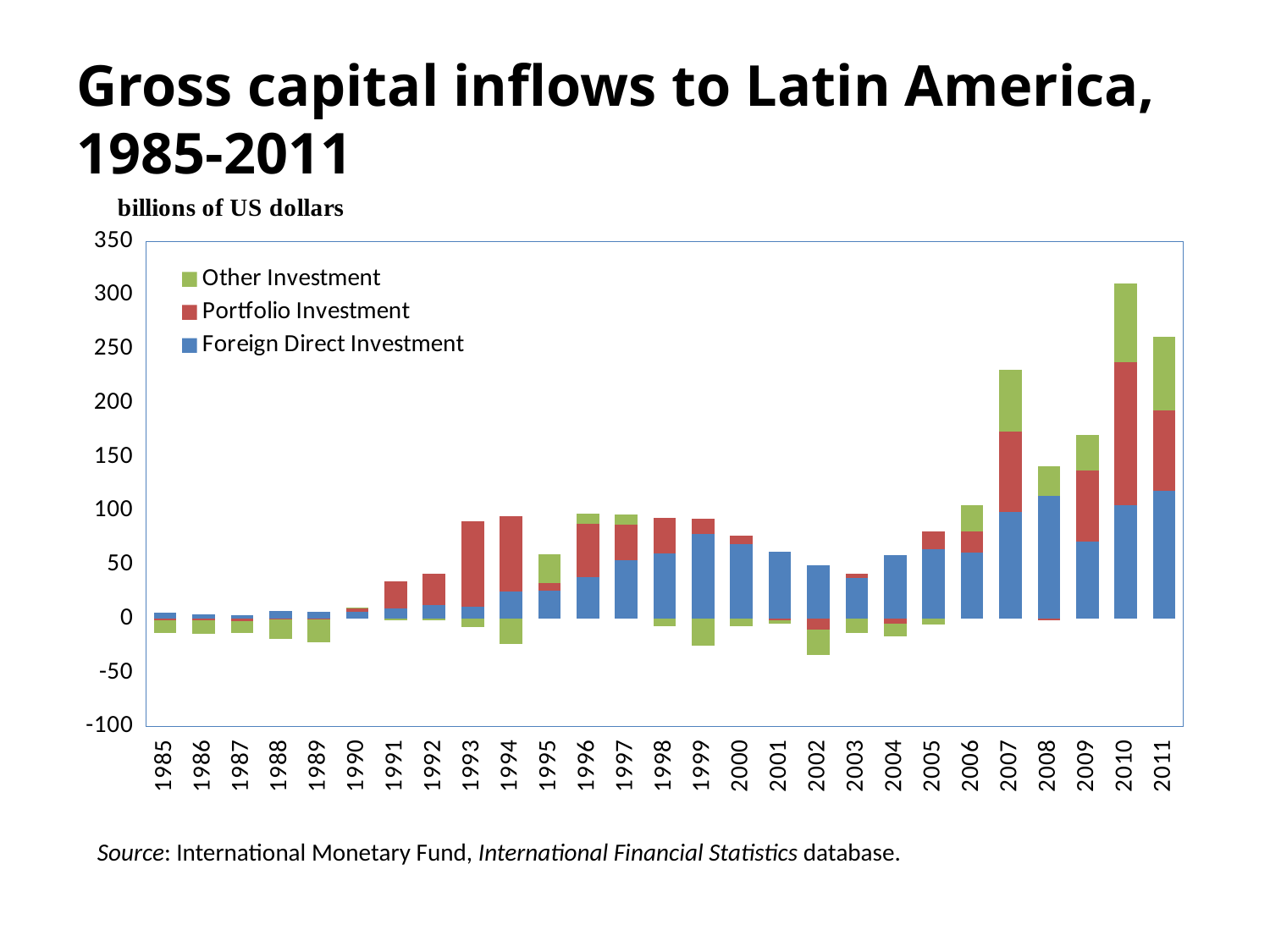
Is the top of the stacked bar for 2010 greater or less than 250? greater What kind of chart is shown on the slide? Stacked bar chart Which year has the larger Foreign Direct Investment value, 2009 or 2011? 2011 How many series does the legend list? 3 Is the Other Investment value for 2002 greater or less than 0? less Is the Foreign Direct Investment value for 2009 greater or less than 50? greater Which year has the tallest stacked bar (highest total gross capital inflows)? 2010 Between 2002 and 2007, does the total height of the stacked bars rise or fall? rise What unit is stated above the chart for the values? billions of US dollars How many years are shown along the x axis? 27